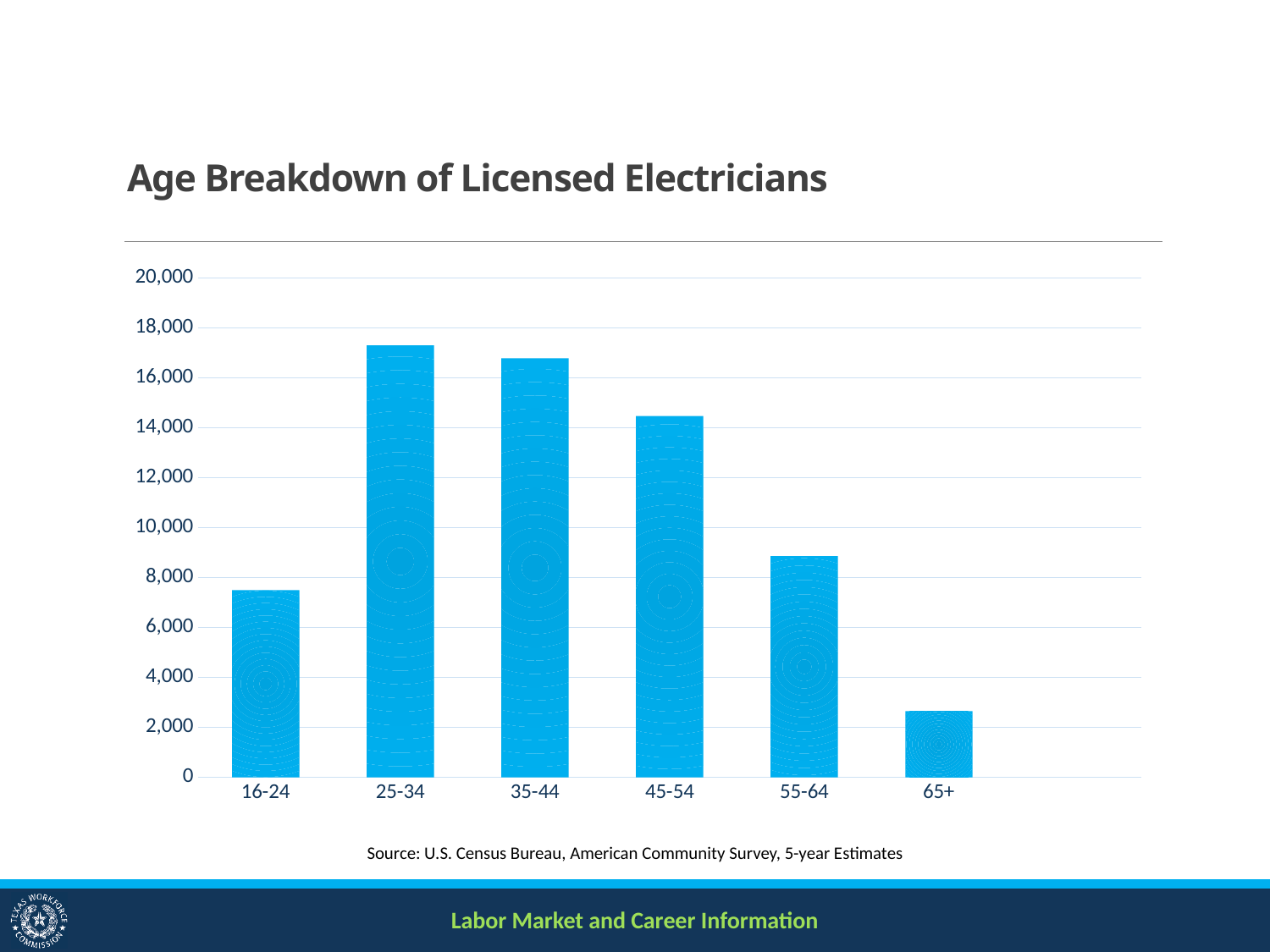
What is the title of the chart? Age Breakdown of Licensed Electricians Which has more licensed electricians, the 16-24 age group or the 55-64 age group? 55-64 Is the value for the 65+ age group greater or less than 4,000? less Which has more licensed electricians, the 45-54 age group or the 55-64 age group? 45-54 Is the value for the 35-44 age group greater or less than 16,000? greater Is the value for the 16-24 age group greater or less than 8,000? less What kind of chart is shown on the slide? bar chart What source is cited below the chart? U.S. Census Bureau, American Community Survey, 5-year Estimates How many age groups are shown on the x axis? 6 Which age group has the lowest number of licensed electricians? 65+